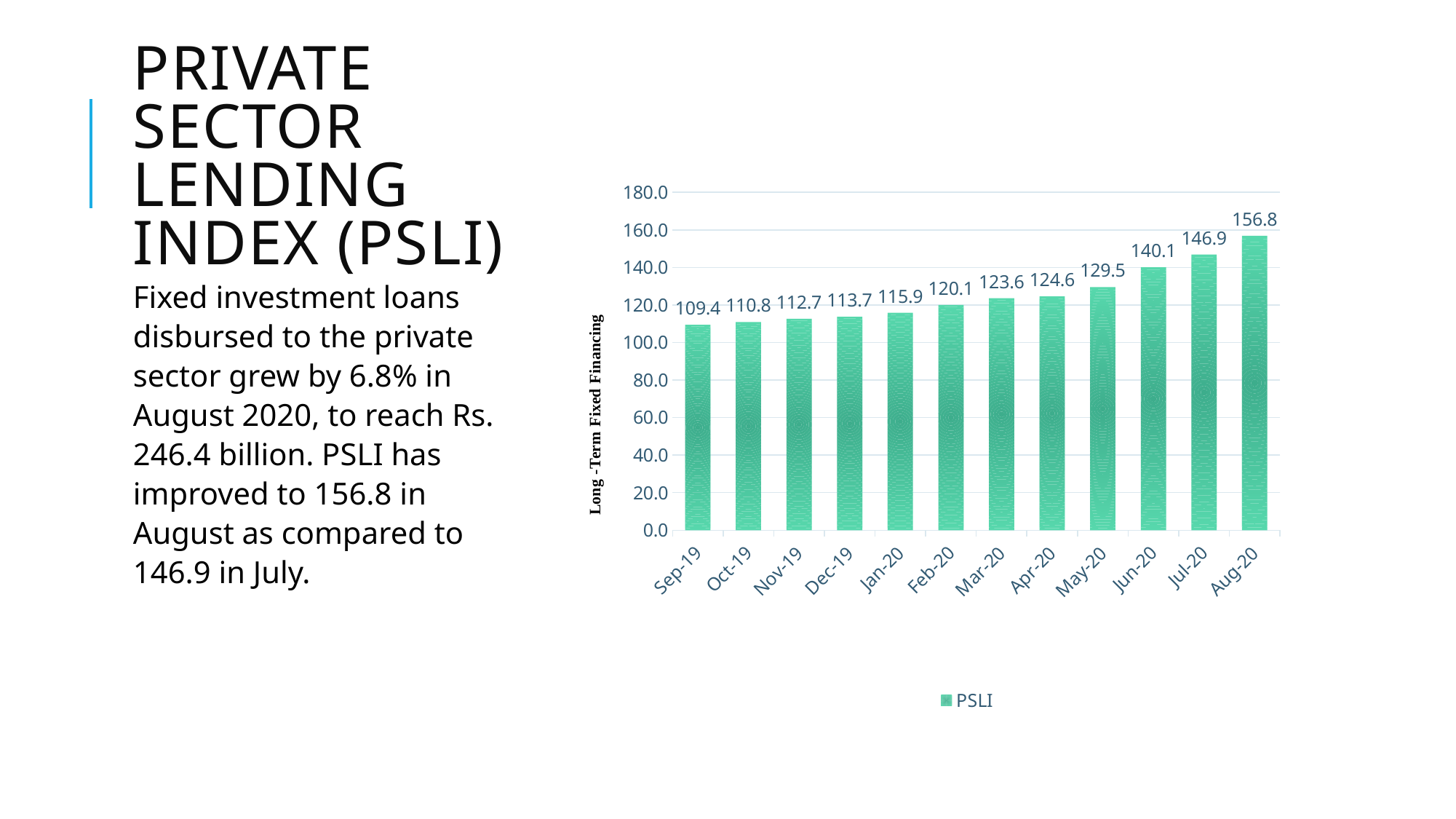
What is the difference between the PSLI values for Aug-20 and Jul-20? 9.9 How many months are shown on the x axis of the chart? 12 What is the PSLI value for Aug-20? 156.8 What kind of chart is shown on the slide? bar chart What is the PSLI value for Sep-19? 109.4 Is the PSLI value for Jan-20 greater or less than 140? less Which is larger, the PSLI value for Jun-20 or for May-20? Jun-20 How many series does the chart legend list? 1 What is the PSLI value for Mar-20? 123.6 Do the PSLI values rise or fall from Sep-19 to Aug-20? rise Which month has the lowest PSLI value? Sep-19 Which month has the highest PSLI value? Aug-20